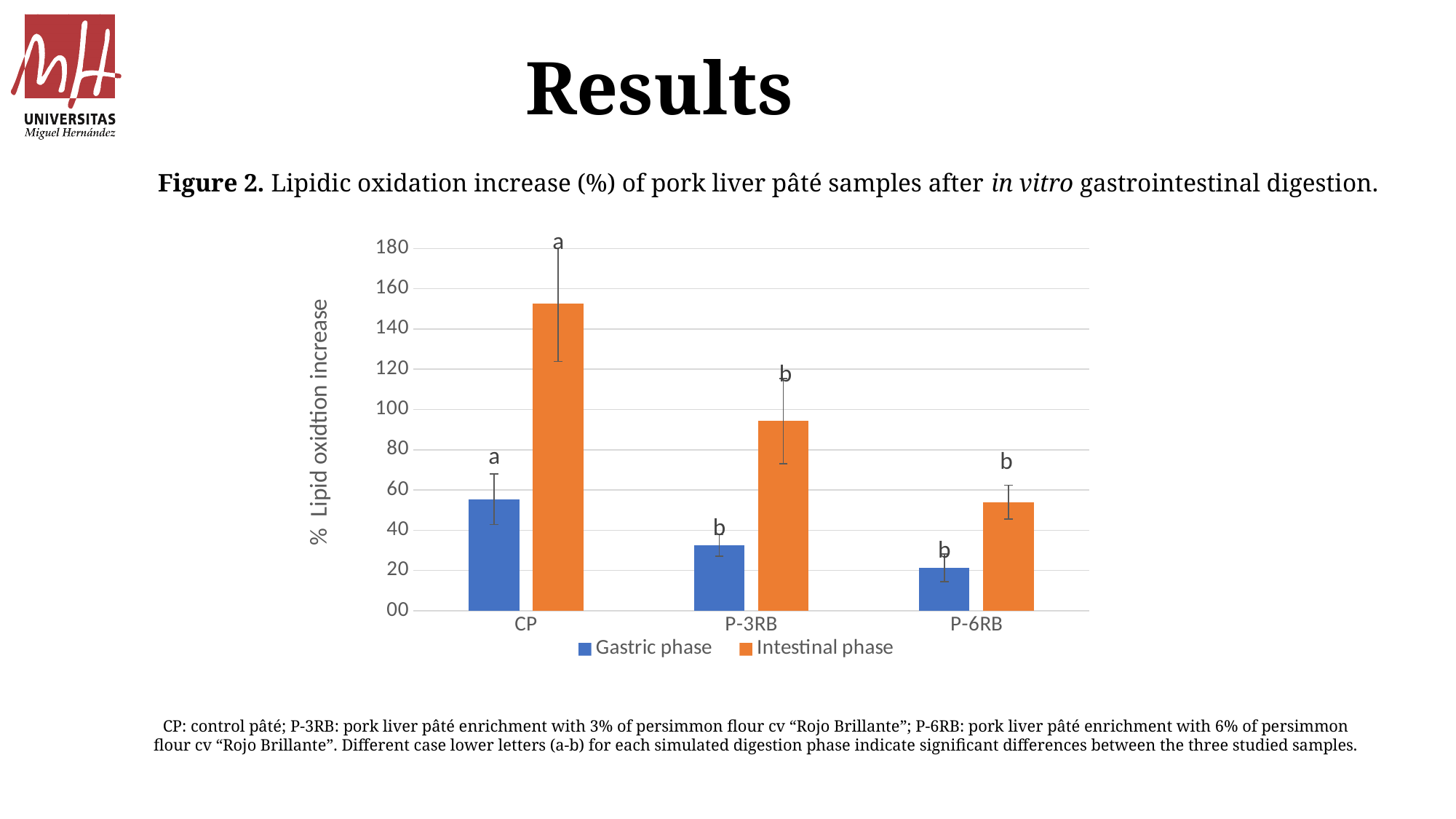
Is the Intestinal phase value for P-3RB greater or less than 80? greater Is the Intestinal phase value for CP greater or less than 140? greater How many sample categories are shown on the x axis? 3 Which sample has the lowest Gastric phase value? P-6RB What are the two legend entries of the chart? Gastric phase and Intestinal phase Is the Gastric phase value for CP greater or less than 40? greater Which sample has the highest Intestinal phase value? CP What kind of chart is shown on the slide? Bar chart Which is larger, the Intestinal phase value for P-3RB or for P-6RB? P-3RB How many series does the legend list? 2 Do the Gastric phase values rise or fall going from CP to P-3RB to P-6RB? fall